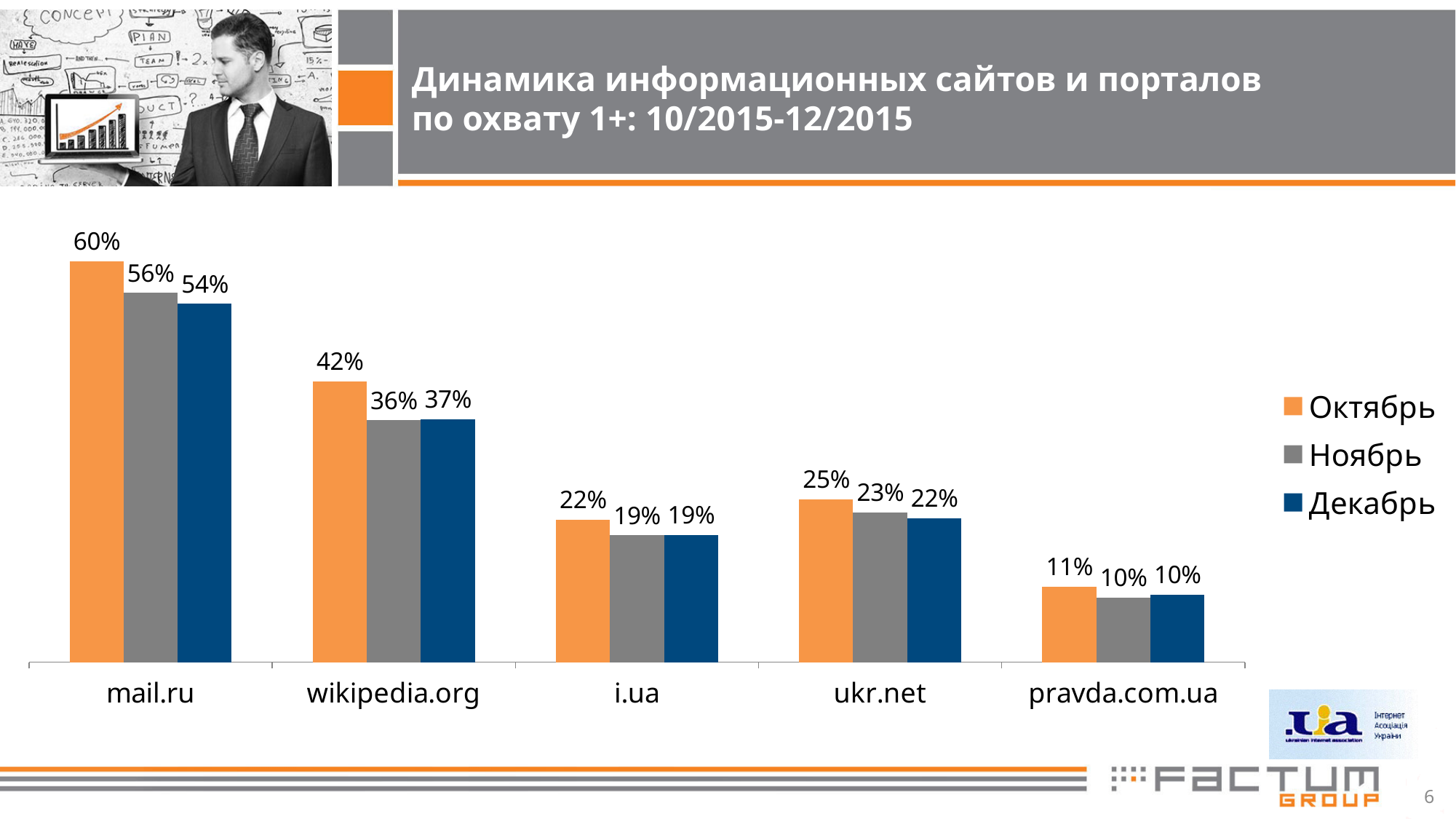
What is the value for ukr.net in Ноябрь? 23% How many series does the legend list? 3 How many sites are shown on the x axis? 5 Which is larger: the Ноябрь value for wikipedia.org or the Ноябрь value for ukr.net? wikipedia.org What is the value for mail.ru in Октябрь? 60% What kind of chart is shown on the slide? Bar chart Which colour represents Декабрь in the legend? Dark blue What is the value for wikipedia.org in Декабрь? 37% Which site has the lowest value in Декабрь? pravda.com.ua Which site has the highest value in Октябрь? mail.ru What is the difference between the Октябрь and Декабрь values for mail.ru? 6%